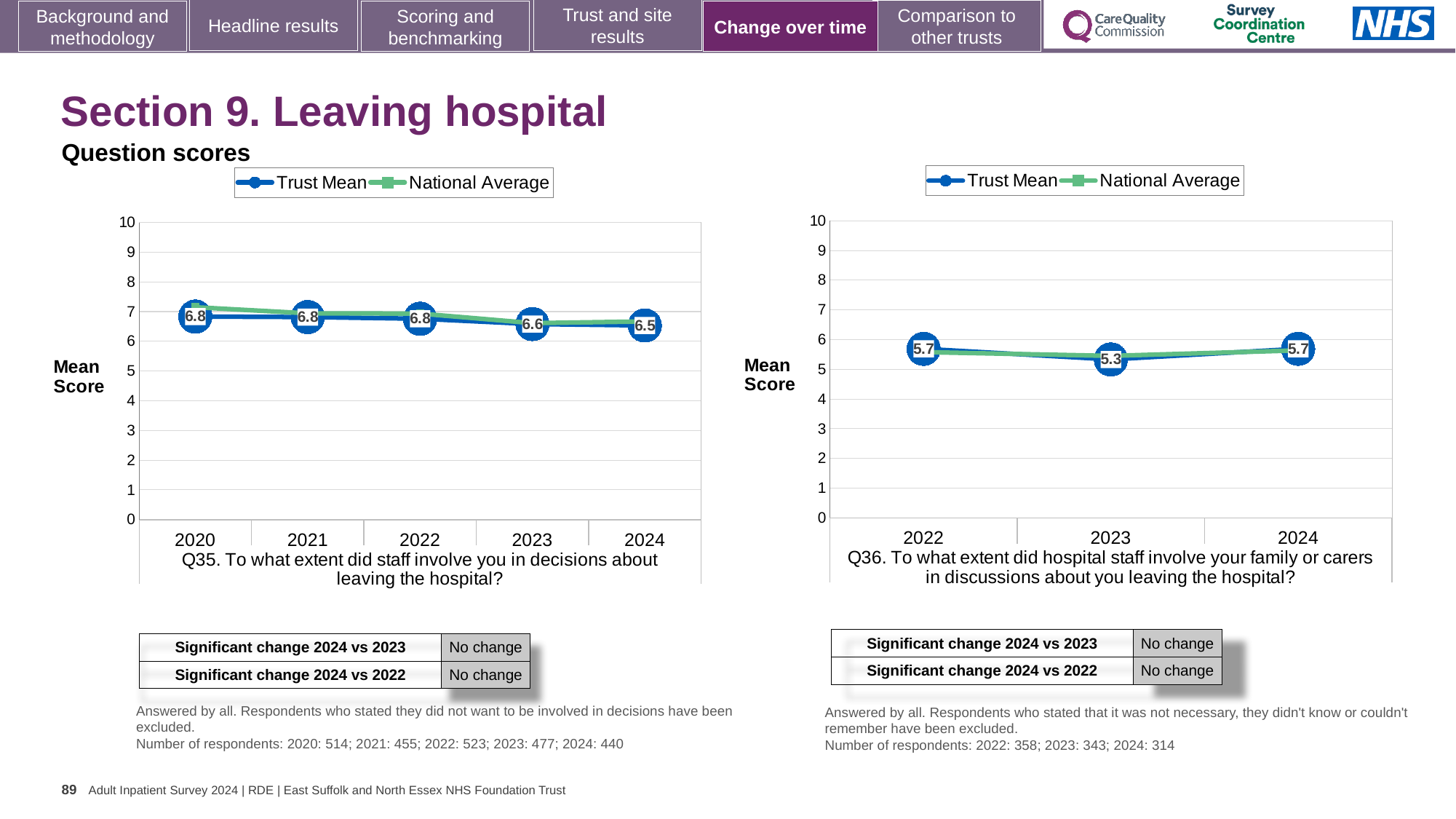
What kind of chart is the Q35 chart on the left? Line chart In the Q35 chart on the left, which year has the lowest Trust Mean score? 2024 In the Q35 chart on the left, what is the Trust Mean score for 2024? 6.5 How many series does the legend of the Q36 chart on the right list? 2 How many years are plotted on the x axis of the Q36 chart on the right? 3 In the Q35 chart on the left, is the Trust Mean score for 2023 greater or less than 7? less In the Q36 chart on the right, what is the Trust Mean score for 2023? 5.3 How many years are plotted on the x axis of the Q35 chart on the left? 5 In the Q36 chart on the right, which year has the lowest Trust Mean score? 2023 In the Q36 chart on the right, what is the difference between the Trust Mean score in 2024 and in 2023? 0.4 In the Q35 chart on the left, what is the Trust Mean score for 2020? 6.8 In the Q35 chart on the left, what is the difference between the Trust Mean score in 2020 and in 2024? 0.3